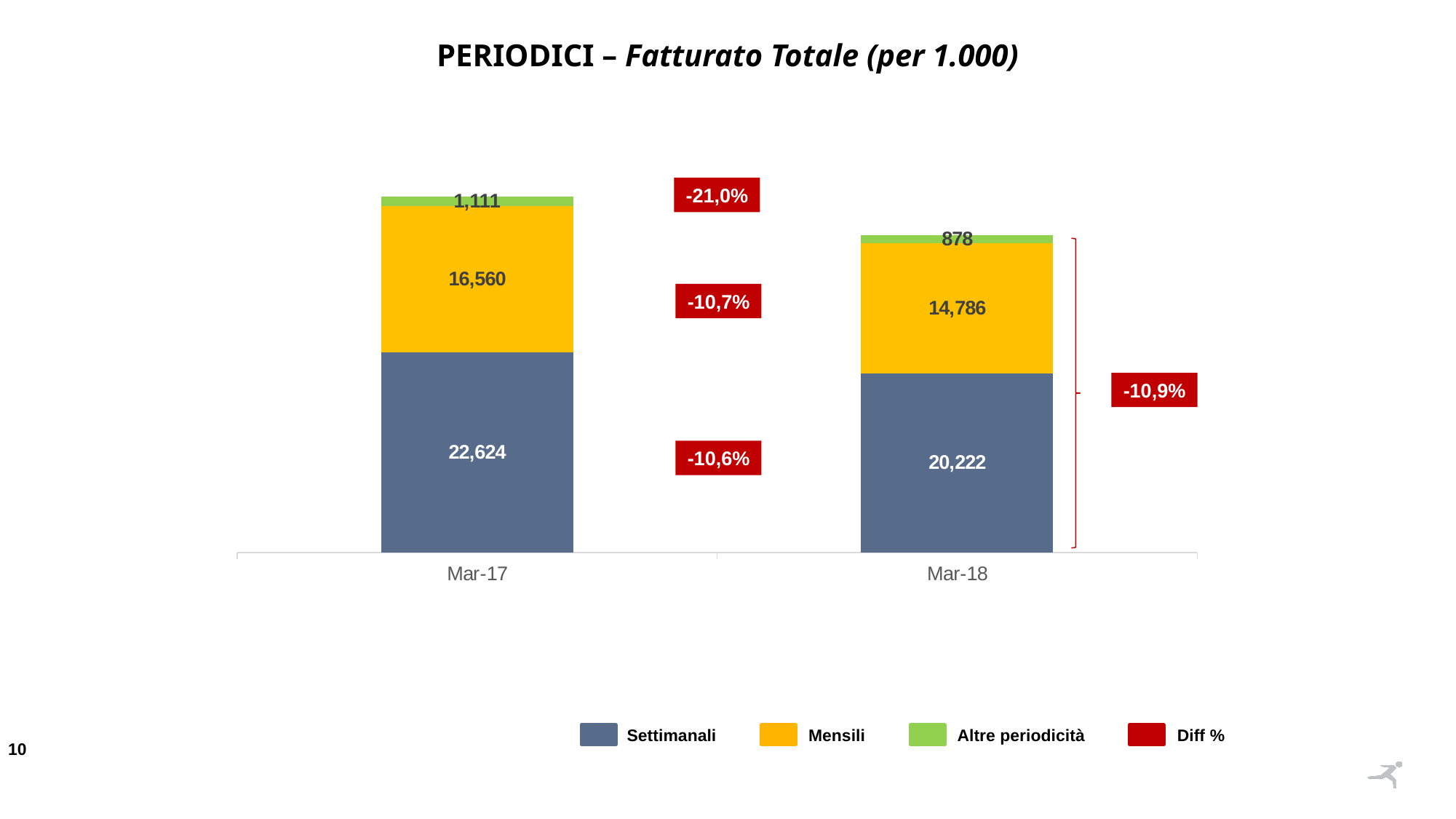
How many entries does the legend list? 4 What is the Diff % shown for Altre periodicità between Mar-17 and Mar-18? -21,0% What kind of chart is shown on the slide? Stacked bar chart What is the total of the stacked bar for Mar-17? 40,295 What is the value for Mensili in Mar-18? 14,786 What is the difference between the Settimanali values for Mar-17 and Mar-18? 2,402 What is the value for Altre periodicità in Mar-17? 1,111 Which is larger, the Mensili value for Mar-17 or for Mar-18? Mar-17 Which series has the lowest value in Mar-18? Altre periodicità What is the overall Diff % shown for the total in Mar-18 versus Mar-17? -10,9% What is the total of the stacked bar for Mar-18? 35,886 What is the value for Settimanali in Mar-17? 22,624